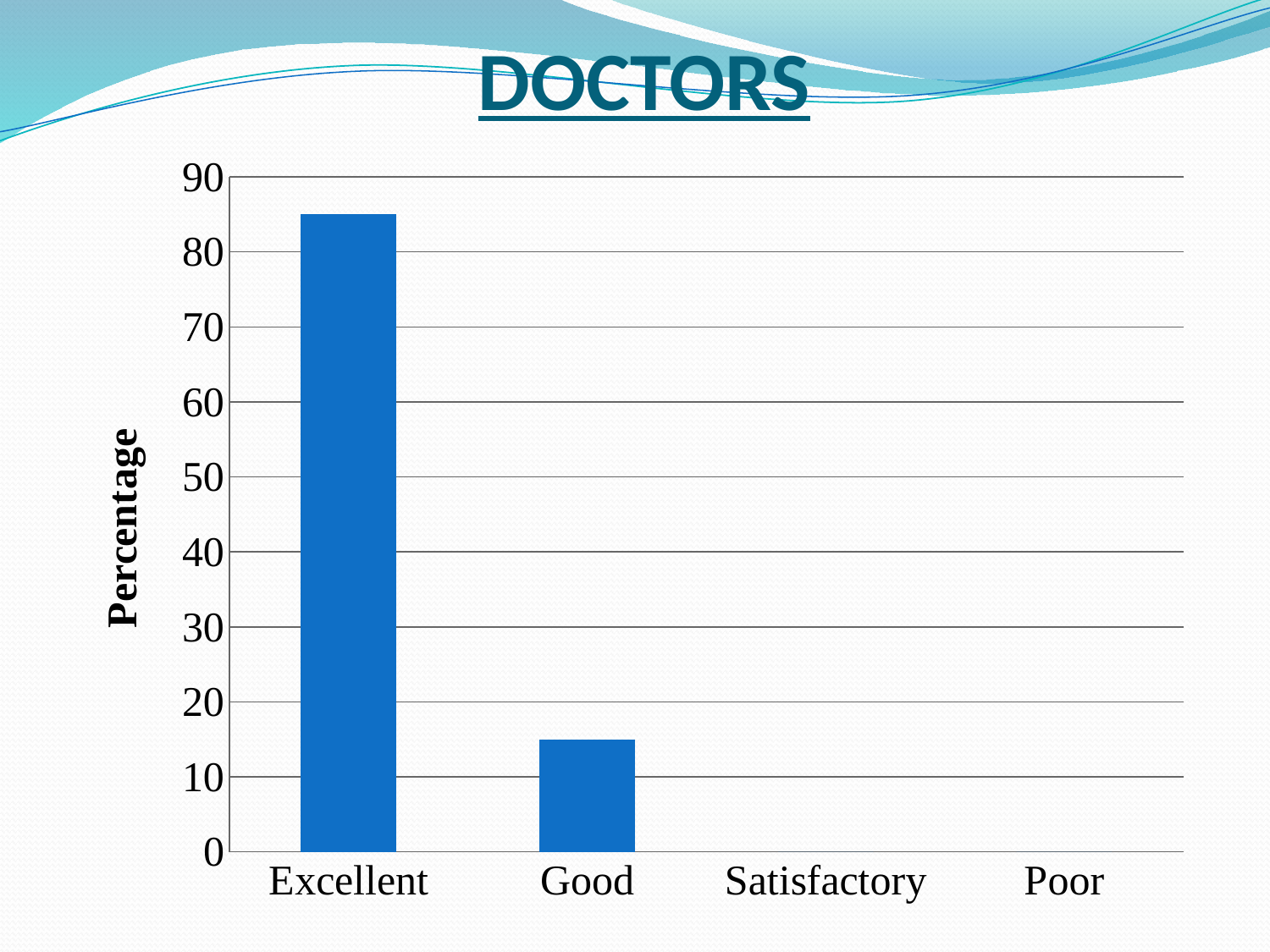
How many categories are shown on the x axis of the chart? 4 Is the value for Excellent greater or less than 80? greater Which category has the highest value in the chart? Excellent What kind of chart is shown on the slide? bar chart Which is larger, the value for Excellent or the value for Good? Excellent What is the title of the slide containing the chart? DOCTORS Is the value for Good greater or less than 20? less What is the label on the y axis of the chart? Percentage Is the value for Good greater or less than 10? greater Do the values rise or fall moving from Excellent to Poor along the x axis? fall Which category has the second-highest value in the chart? Good